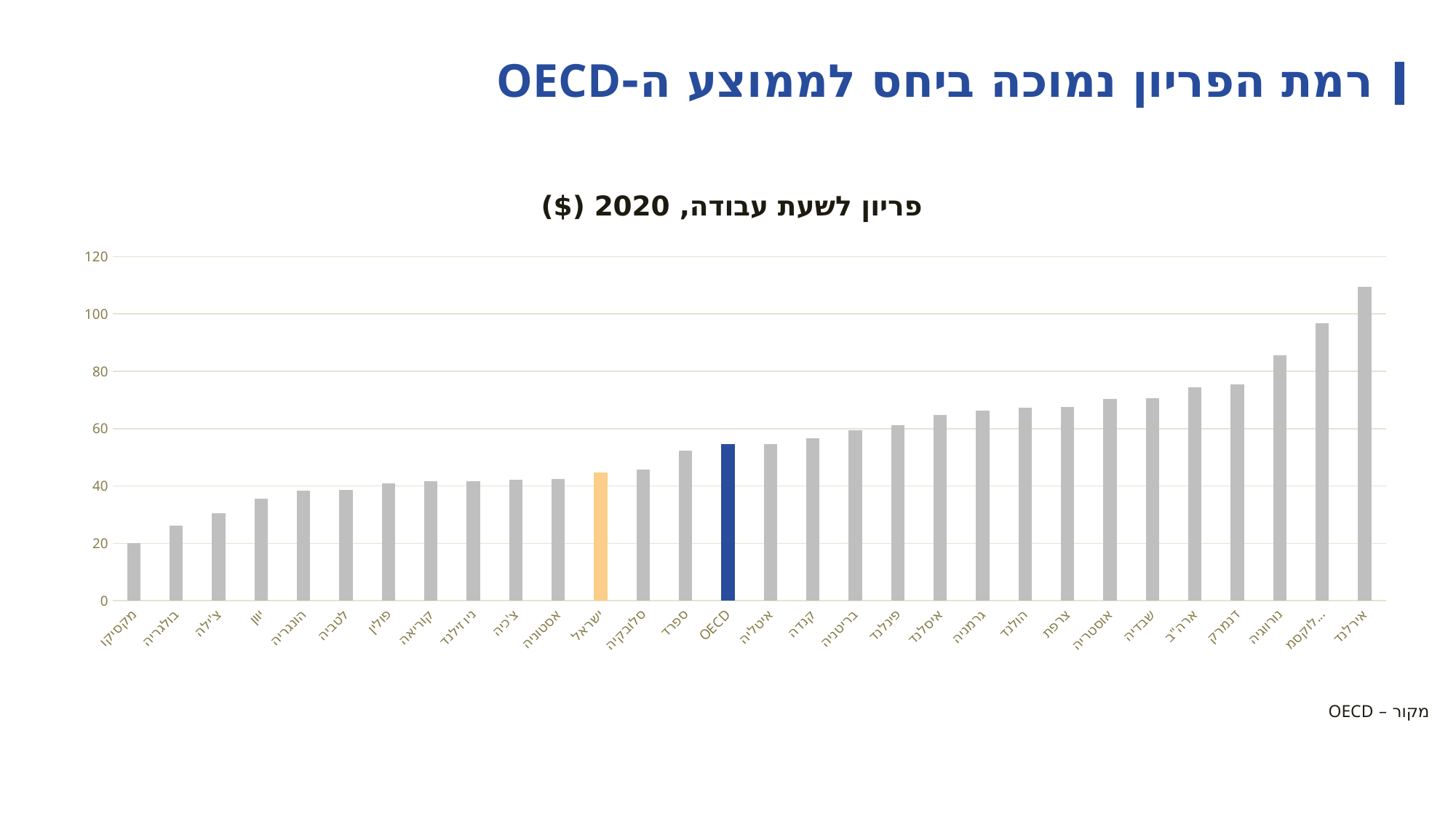
Is the value for OECD greater or less than 60? less Is the value for ישראל greater or less than 40? greater Do the bar values rise or fall from left to right along the x axis? Rise Which is larger, the value for יוון or the value for צ'ילה? יוון Is the value for אירלנד greater or less than 100? greater Which is larger, the value for ישראל or the value for OECD? OECD How many bars are plotted in the chart? 30 What colour is the bar for ישראל? Orange (light yellow-orange) What kind of chart is shown on the slide? Bar chart Which country has the highest productivity per work hour in the chart? אירלנד Which country has the lowest productivity per work hour in the chart? מקסיקו